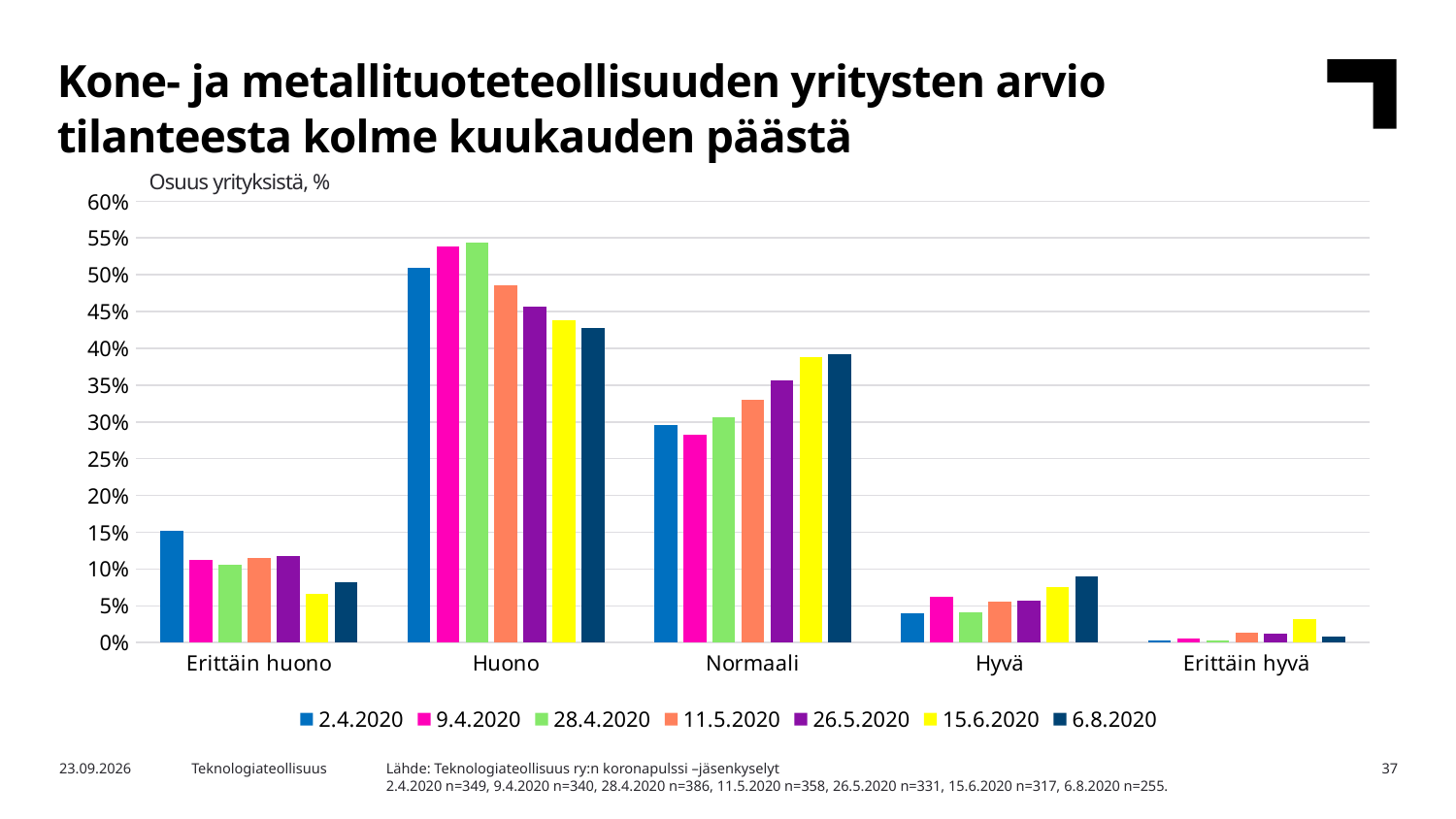
Which category has the lowest value for the 6.8.2020 series? Erittäin hyvä For the Hyvä category, which is larger: the 2.4.2020 value or the 6.8.2020 value? 6.8.2020 What is the label shown above the vertical axis of the chart? Osuus yrityksistä, % For the Huono category, which is larger: the 28.4.2020 value or the 6.8.2020 value? 28.4.2020 How many categories are shown on the x axis? 5 Is the value for Erittäin huono in the 15.6.2020 series greater or less than 10%? less How many series does the legend list? 7 Is the value for Huono in the 9.4.2020 series greater or less than 50%? greater What kind of chart is shown on the slide? bar chart For the Huono category, do the values rise or fall from the 28.4.2020 series to the 6.8.2020 series? fall Is the value for Normaali in the 6.8.2020 series greater or less than 35%? greater Which category has the highest value for the 2.4.2020 series? Huono